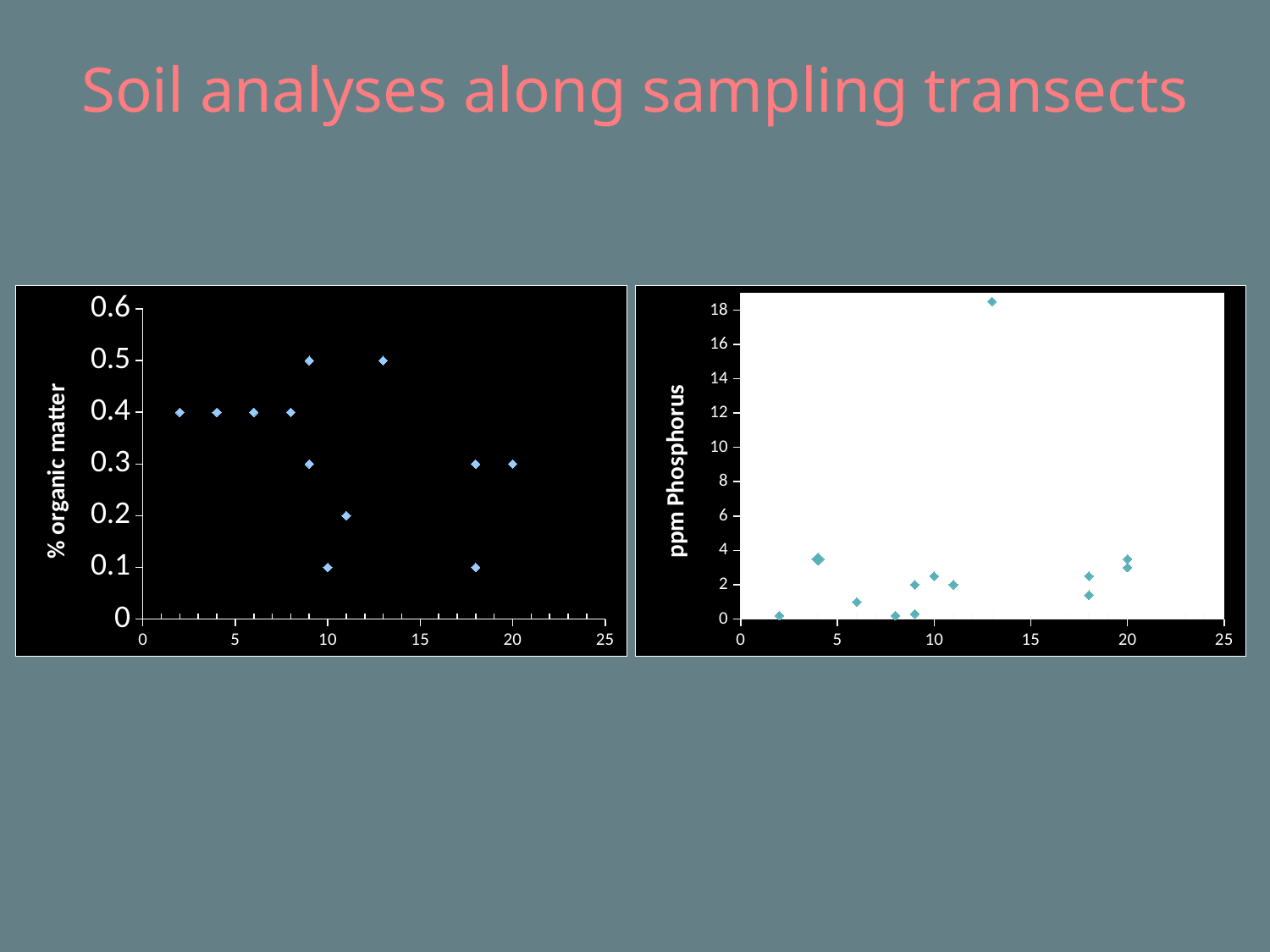
In the left chart (% organic matter), which has the larger y value: the point at x = 11 or the point at x = 13? x = 13 What kind of chart is the right chart (ppm Phosphorus)? scatter chart In the right chart (ppm Phosphorus), is the value of the point at x = 13 greater or less than 16? greater In the right chart (ppm Phosphorus), which has the larger y value: the point at x = 4 or the point at x = 6? x = 4 In the left chart (% organic matter), what is the y value of the point at x = 11? 0.2 In the right chart (ppm Phosphorus), at which x value is the highest point plotted? 13 In the left chart (% organic matter), what is the lowest y value plotted? 0.1 In the left chart (% organic matter), what is the highest y value plotted? 0.5 In the left chart (% organic matter), what is the y value of the point at x = 2? 0.4 What is the y-axis label of the right chart? ppm Phosphorus What kind of chart is the left chart (% organic matter)? scatter chart